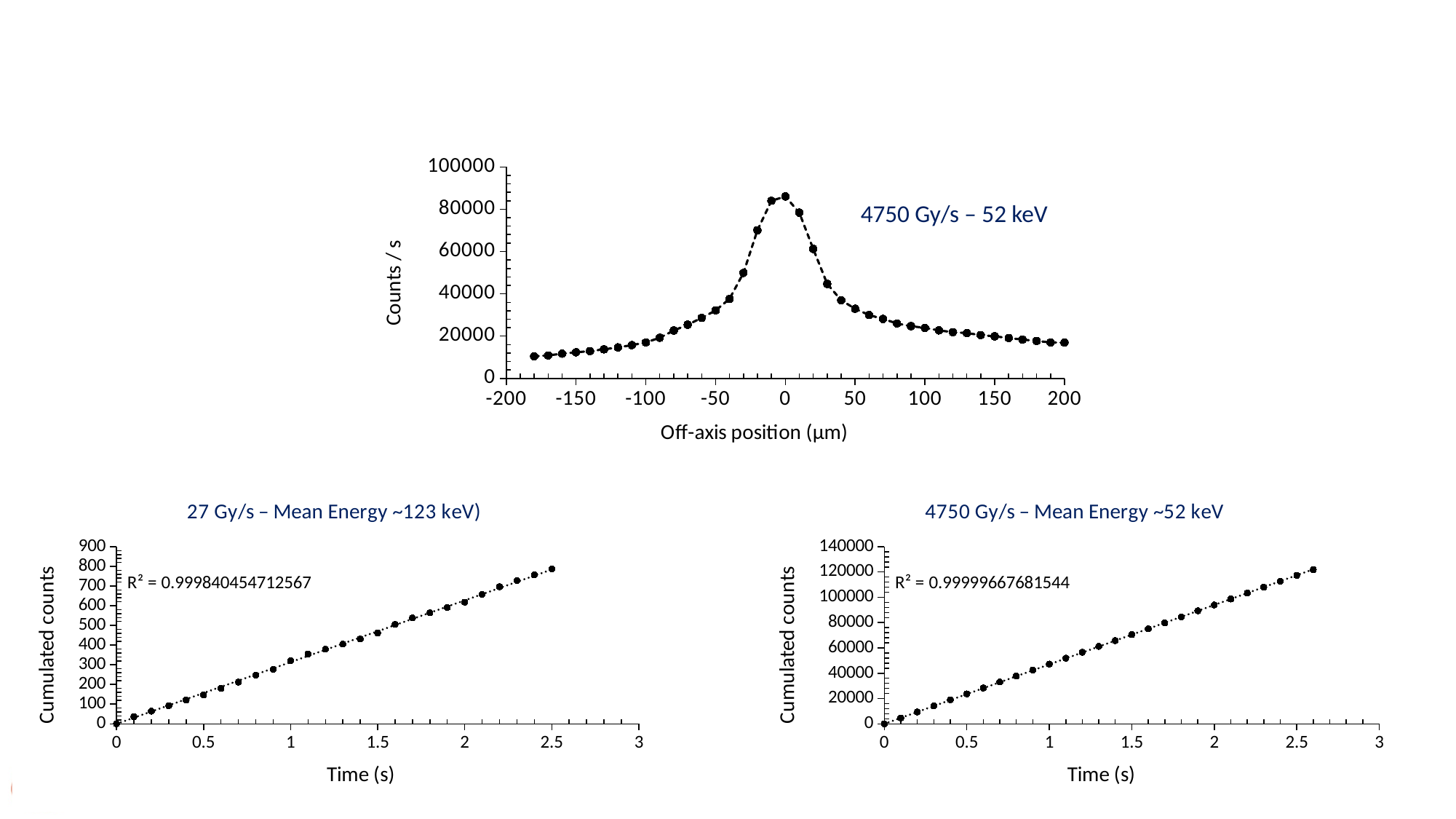
In the top chart (4750 Gy/s – 52 keV), is the peak value of Counts / s greater or less than 80000? greater In the top chart (4750 Gy/s – 52 keV), is the value at an off-axis position of 200 µm greater or less than 20000? less In the bottom-left chart (27 Gy/s – Mean Energy ~123 keV), is the cumulated count at 2.5 s greater or less than 700? greater In the top chart (4750 Gy/s – 52 keV), do the counts rise or fall as the off-axis position goes from -200 µm toward 0 µm? rise How many charts are shown on the slide? 3 In the bottom-right chart (4750 Gy/s – Mean Energy ~52 keV), what R² value is printed? R² = 0.99999667681544 In the bottom-left chart (27 Gy/s – Mean Energy ~123 keV), do the cumulated counts rise or fall over time? rise In the bottom-left chart (27 Gy/s – Mean Energy ~123 keV), what R² value is printed? R² = 0.999840454712567 In the top chart (4750 Gy/s – 52 keV), is the value at 50 µm larger or smaller than the value at 150 µm? larger In the top chart (4750 Gy/s – 52 keV), what is the label of the y axis? Counts / s In the top chart (4750 Gy/s – 52 keV), what is the label of the x axis? Off-axis position (µm)